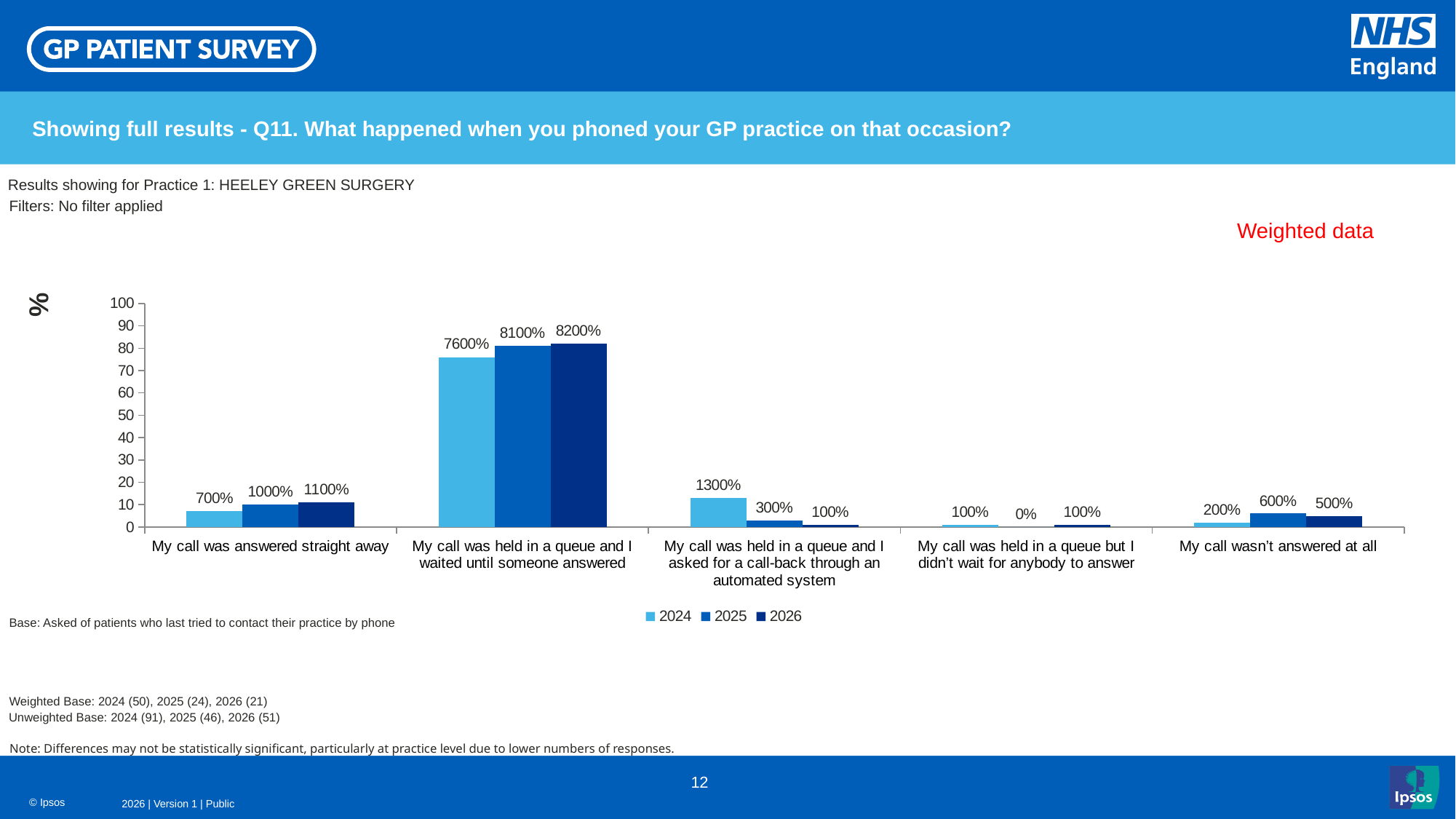
Which practice are the results shown for? Practice 1: HEELEY GREEN SURGERY How many response categories are shown on the x axis? 5 What is the 2025 value for 'My call wasn't answered at all'? 600% How many series does the legend list? 3 Which category has the lowest 2025 value? My call was held in a queue but I didn't wait for anybody to answer What is the 2024 value for 'My call was held in a queue and I asked for a call-back through an automated system'? 1300% What kind of chart is shown on the slide? Bar chart What is the difference between the 2026 and 2024 values for 'My call was held in a queue and I waited until someone answered', as labelled? 600% For 'My call was answered straight away', which year has the larger value, 2024 or 2026? 2026 What is the 2026 value for 'My call was held in a queue and I waited until someone answered'? 8200% Which category has the highest 2024 value? My call was held in a queue and I waited until someone answered What is the 2025 value for 'My call was held in a queue but I didn't wait for anybody to answer'? 0%